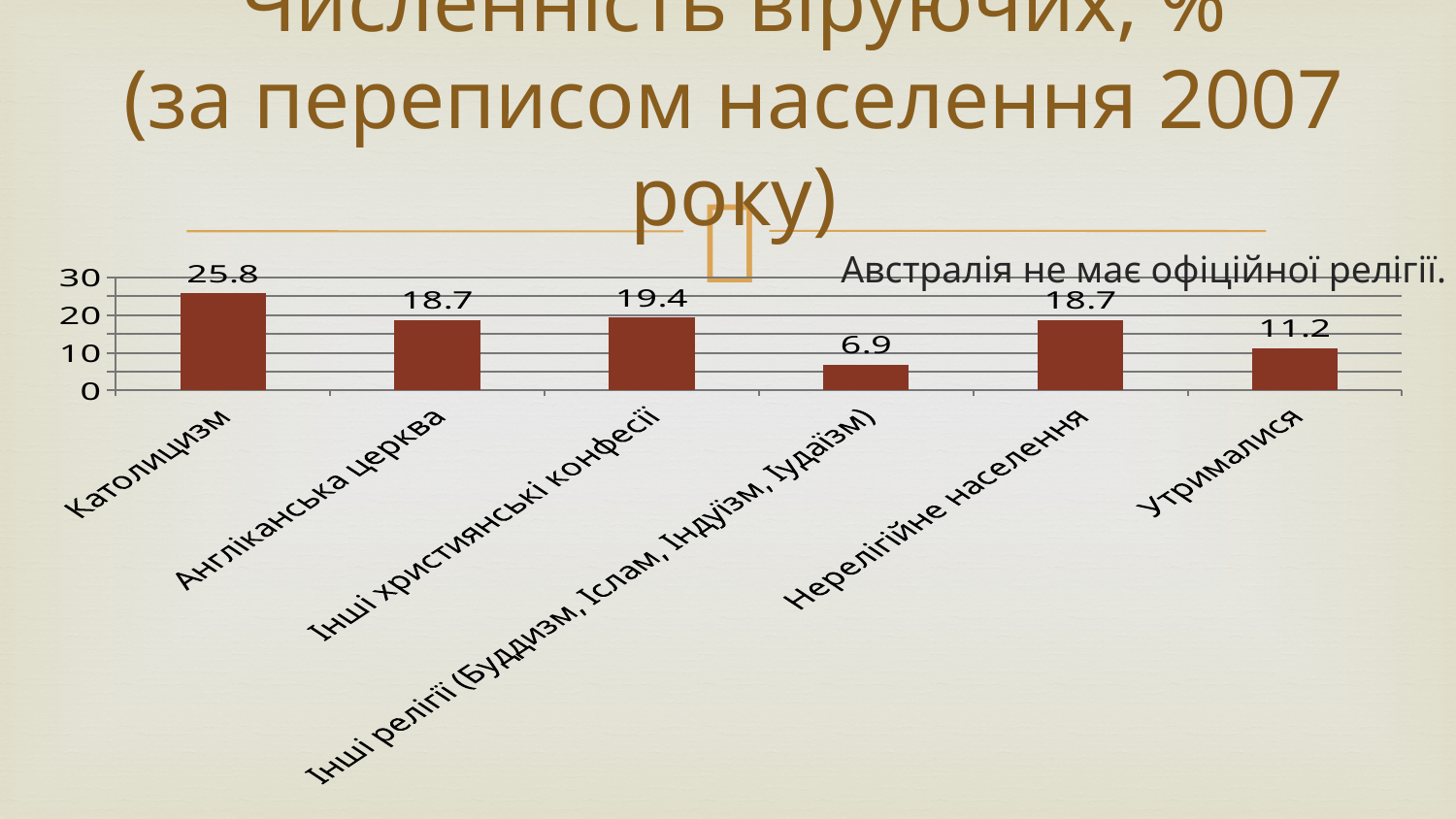
What is the difference between the values for Католицизм and Утрималися? 14.6 What is the value for Інші релігії (Буддизм, Іслам, Індуїзм, Іудаїзм)? 6.9 How many categories are shown in the chart? 6 What kind of chart is shown on the slide? bar chart Which category has the lowest value? Інші релігії (Буддизм, Іслам, Індуїзм, Іудаїзм) What is the value for Католицизм? 25.8 What is the difference between the values for Інші християнські конфесії and Англіканська церква? 0.7 What is the value for Нерелігійне населення? 18.7 Is the value for Католицизм greater or less than 20? greater Which is larger, the value for Інші християнські конфесії or the value for Утрималися? Інші християнські конфесії What is the value for Утрималися? 11.2 Which category has the highest value? Католицизм